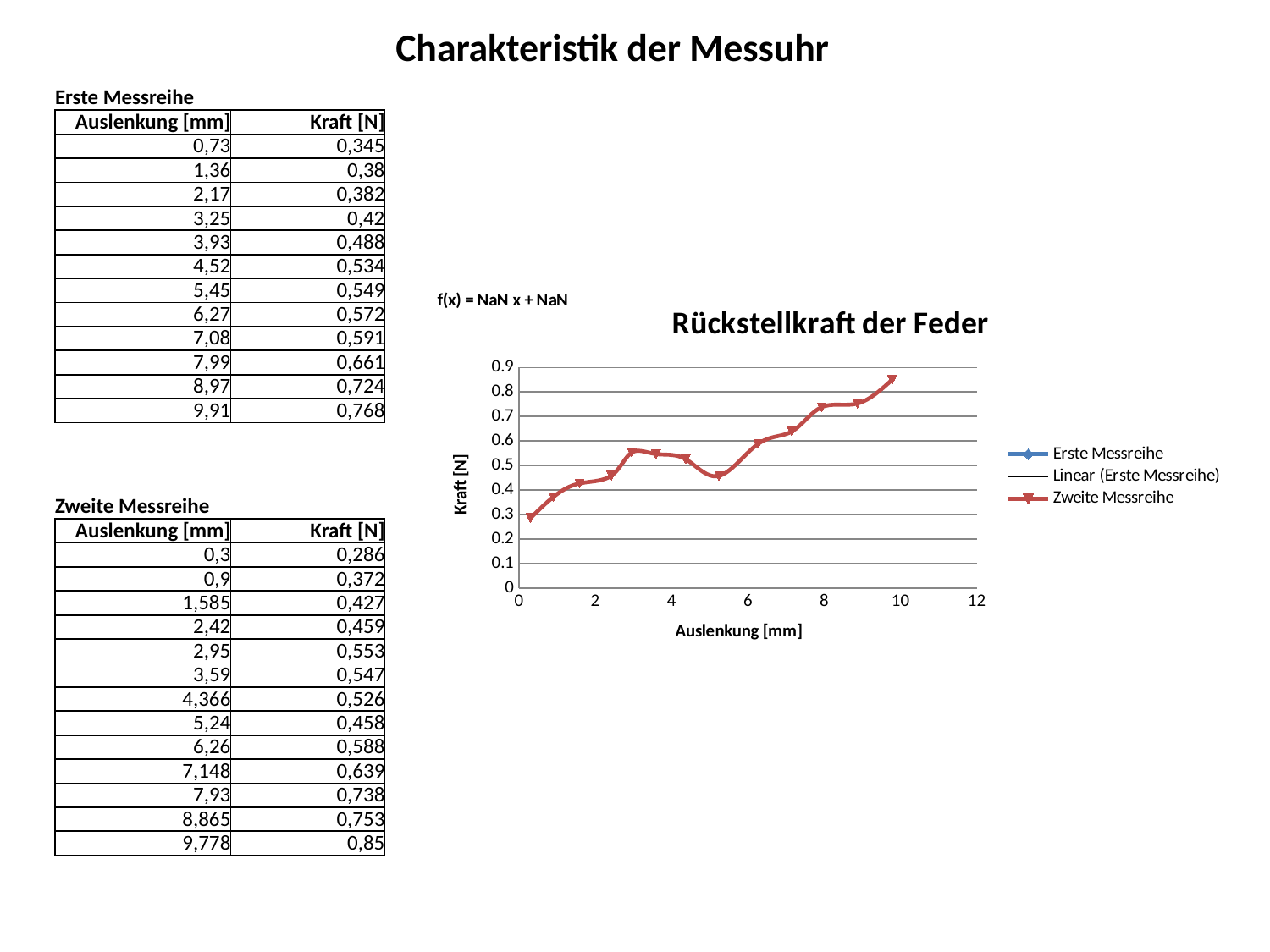
What is the label of the y axis of the "Rückstellkraft der Feder" chart? Kraft [N] In the "Rückstellkraft der Feder" chart, does the Kraft of Zweite Messreihe generally rise or fall as Auslenkung increases? rise In the "Rückstellkraft der Feder" chart, is the Kraft value of Zweite Messreihe at an Auslenkung of about 7.9 mm greater or less than 0.7? greater What kind of chart is "Rückstellkraft der Feder"? line chart How many data points are plotted for Zweite Messreihe in the "Rückstellkraft der Feder" chart? 13 According to the Zweite Messreihe table, what is the lowest Kraft value plotted in the "Rückstellkraft der Feder" chart? 0,286 In the "Rückstellkraft der Feder" chart, which is larger for Zweite Messreihe: the Kraft at about 3 mm Auslenkung or the Kraft at about 5.2 mm Auslenkung? about 3 mm In the "Rückstellkraft der Feder" chart, is the Kraft value of Zweite Messreihe at an Auslenkung of about 5.2 mm greater or less than 0.5? less What is the label of the x axis of the "Rückstellkraft der Feder" chart? Auslenkung [mm] In the "Rückstellkraft der Feder" chart, is the Kraft value of Zweite Messreihe at the largest Auslenkung (about 9.8 mm) greater or less than 0.8? greater According to the Zweite Messreihe table, what is the highest Kraft value plotted in the "Rückstellkraft der Feder" chart? 0,85 How many series does the legend of the "Rückstellkraft der Feder" chart list? 3